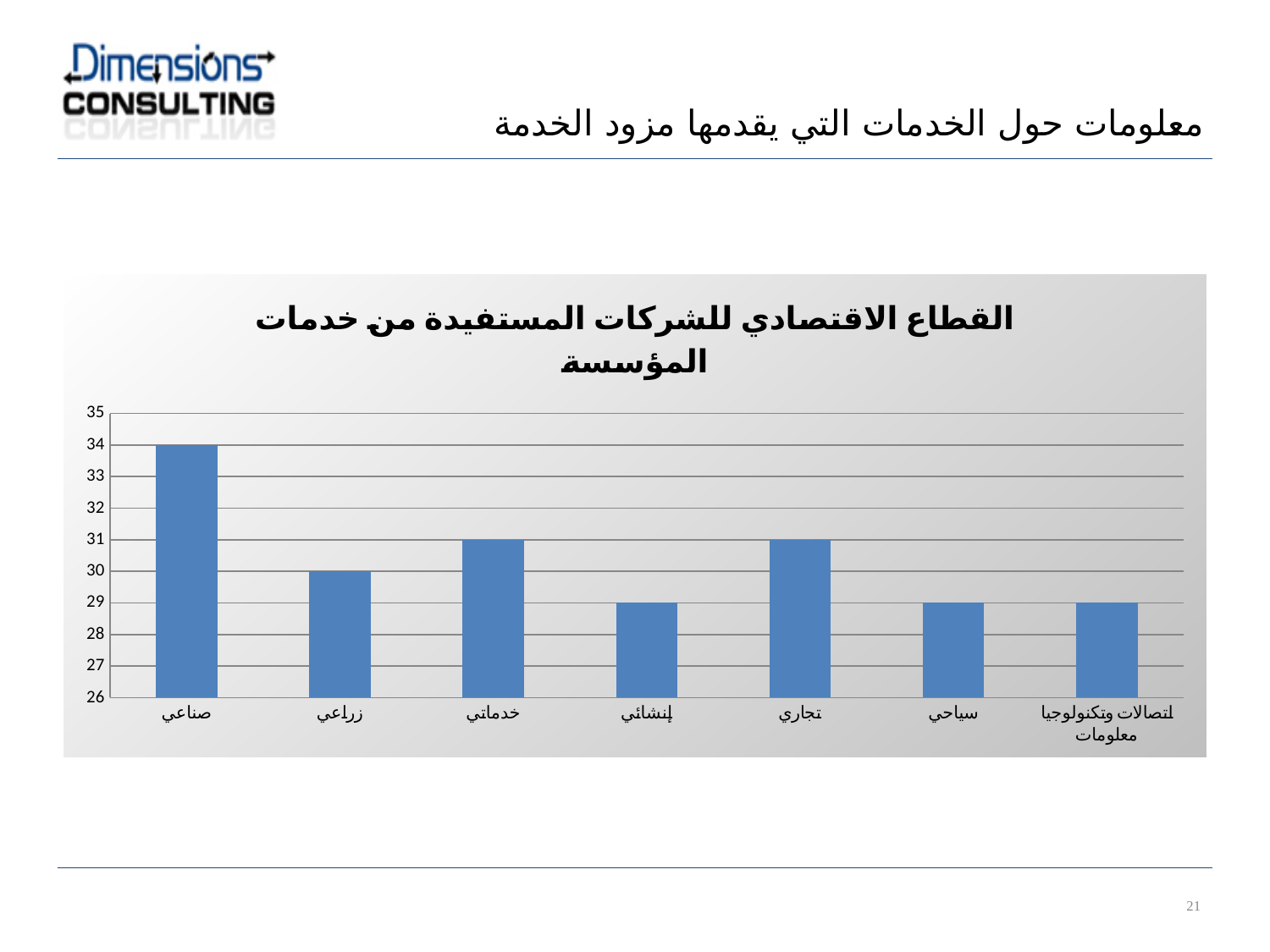
How many categories are shown on the x axis? 7 What is the title of the chart? القطاع الاقتصادي للشركات المستفيدة من خدمات المؤسسة What is the difference between the values for صناعي and زراعي? 4 Is the value for تجاري greater or less than 30? greater Which is larger, the value for خدماتي or the value for سياحي? خدماتي Which category has the highest value? صناعي What type of chart is shown on the slide? Bar chart What is the value for صناعي? 34 What is the value for خدماتي? 31 What is the value for زراعي? 30 What is the value for إنشائي? 29 What is the lowest value shown on the vertical axis? 26